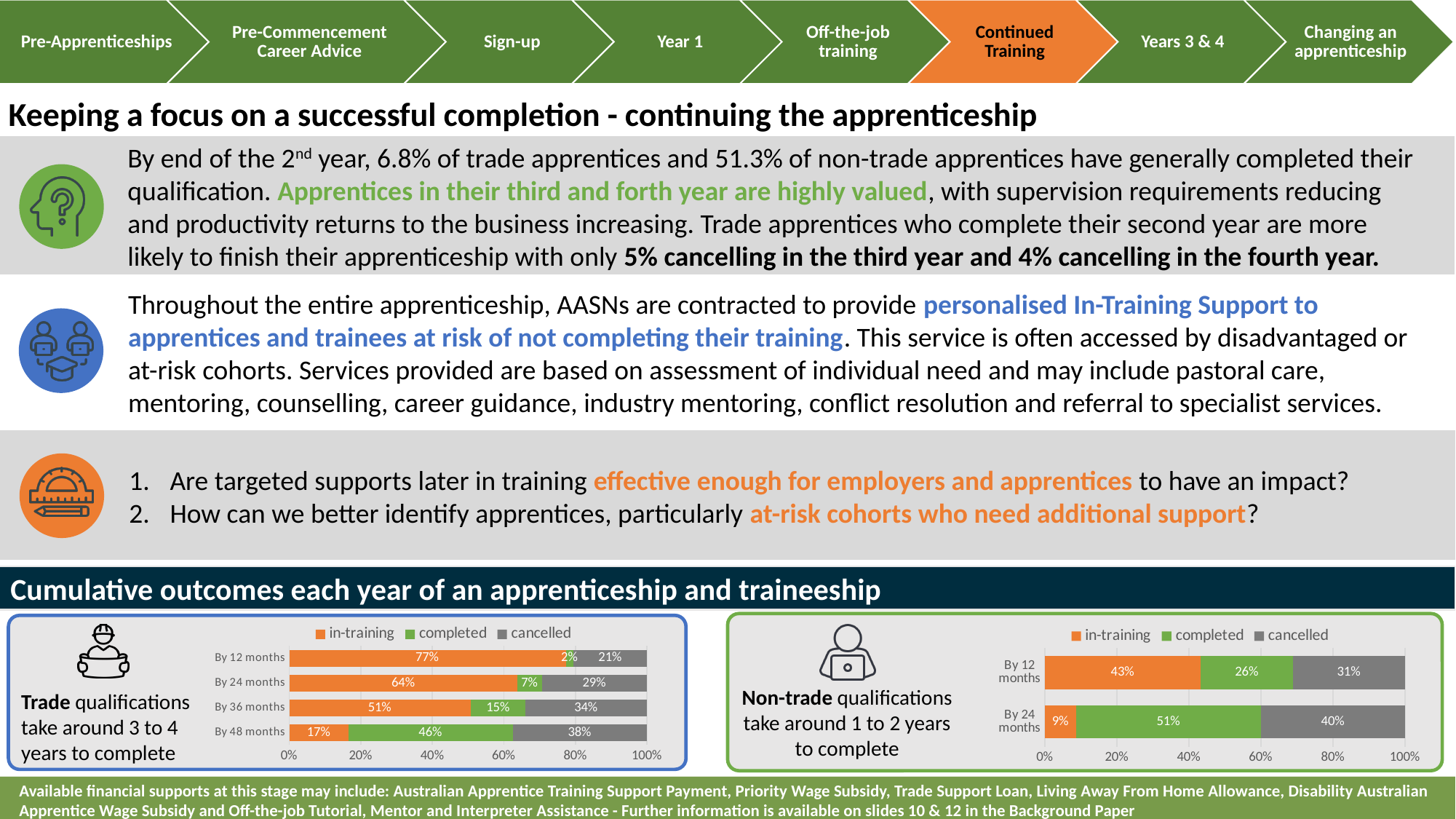
How many time periods are shown in the Trade qualifications chart? 4 In the Trade qualifications chart, what is the difference between the cancelled values for By 48 months and By 12 months? 17% In the Non-trade qualifications chart, which is larger: the cancelled value for By 24 months or the cancelled value for By 12 months? By 24 months In the Trade qualifications chart, what is the in-training value for By 12 months? 77% How many series does the legend of the Non-trade qualifications chart list? 3 In the Trade qualifications chart, what is the cancelled value for By 36 months? 34% In the Trade qualifications chart, what is the completed value for By 48 months? 46% In the Trade qualifications chart, which time period has the highest completed value? By 48 months What kind of chart is the Non-trade qualifications chart? Stacked bar chart In the Non-trade qualifications chart, what is the in-training value for By 12 months? 43% In the Trade qualifications chart, which time period has the lowest in-training value? By 48 months In the Non-trade qualifications chart, what is the completed value for By 24 months? 51%